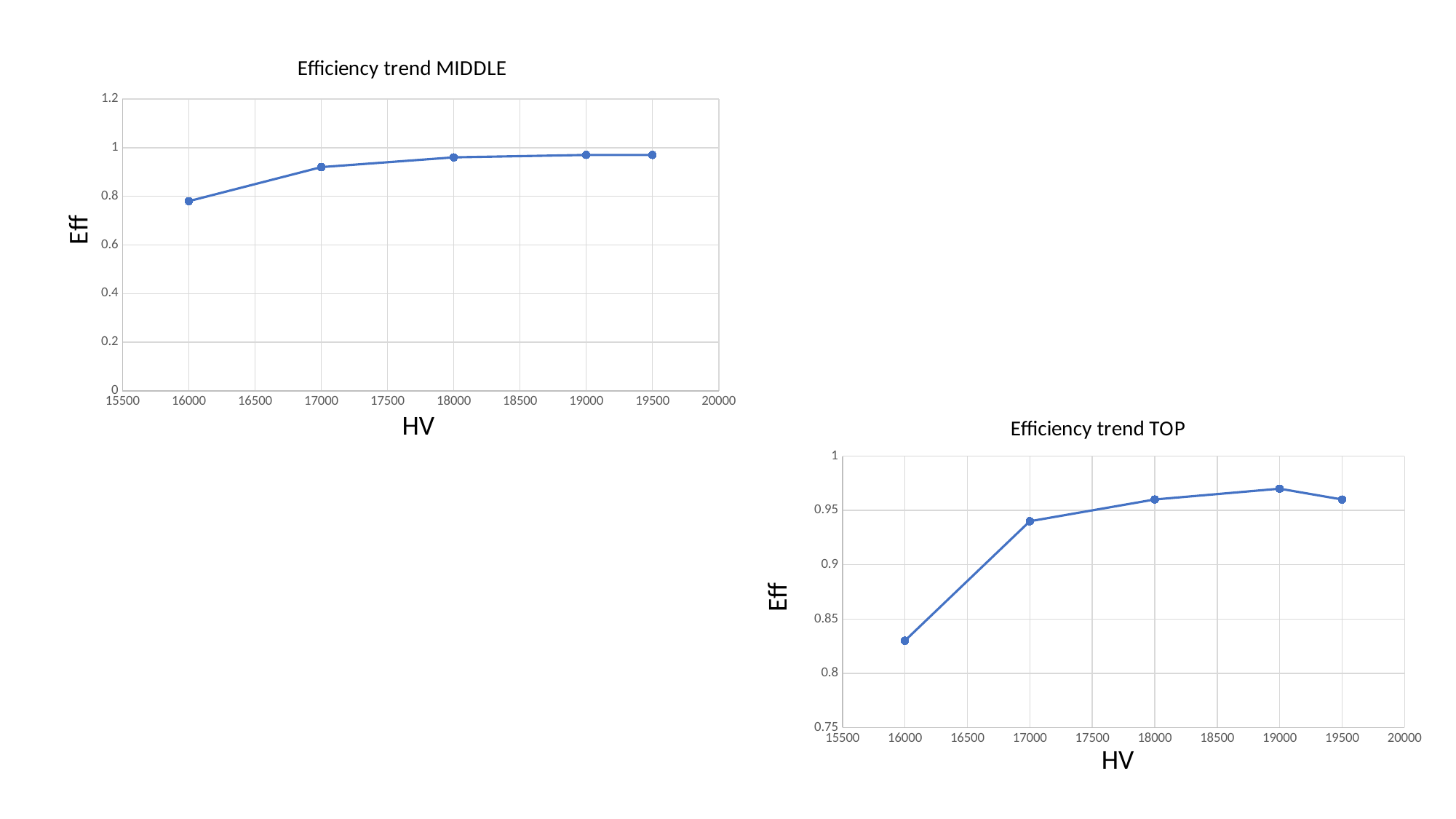
In the "Efficiency trend TOP" chart, is the Eff value at HV 16000 greater or less than 0.85? less In the "Efficiency trend TOP" chart, how many data points are plotted? 5 In the "Efficiency trend MIDDLE" chart, does Eff generally rise or fall as HV increases? rise In the "Efficiency trend MIDDLE" chart, is the Eff value at HV 16000 greater or less than 0.8? less What kind of chart is "Efficiency trend MIDDLE"? line chart What is the label of the x axis on the "Efficiency trend TOP" chart? HV In the "Efficiency trend TOP" chart, at which HV value is Eff lowest? 16000 In the "Efficiency trend MIDDLE" chart, is the Eff value at HV 18000 greater or less than 0.8? greater In the "Efficiency trend MIDDLE" chart, how many data points are plotted? 5 In the "Efficiency trend MIDDLE" chart, which has the higher Eff: HV 16000 or HV 17000? 17000 In the "Efficiency trend MIDDLE" chart, at which HV value is Eff lowest? 16000